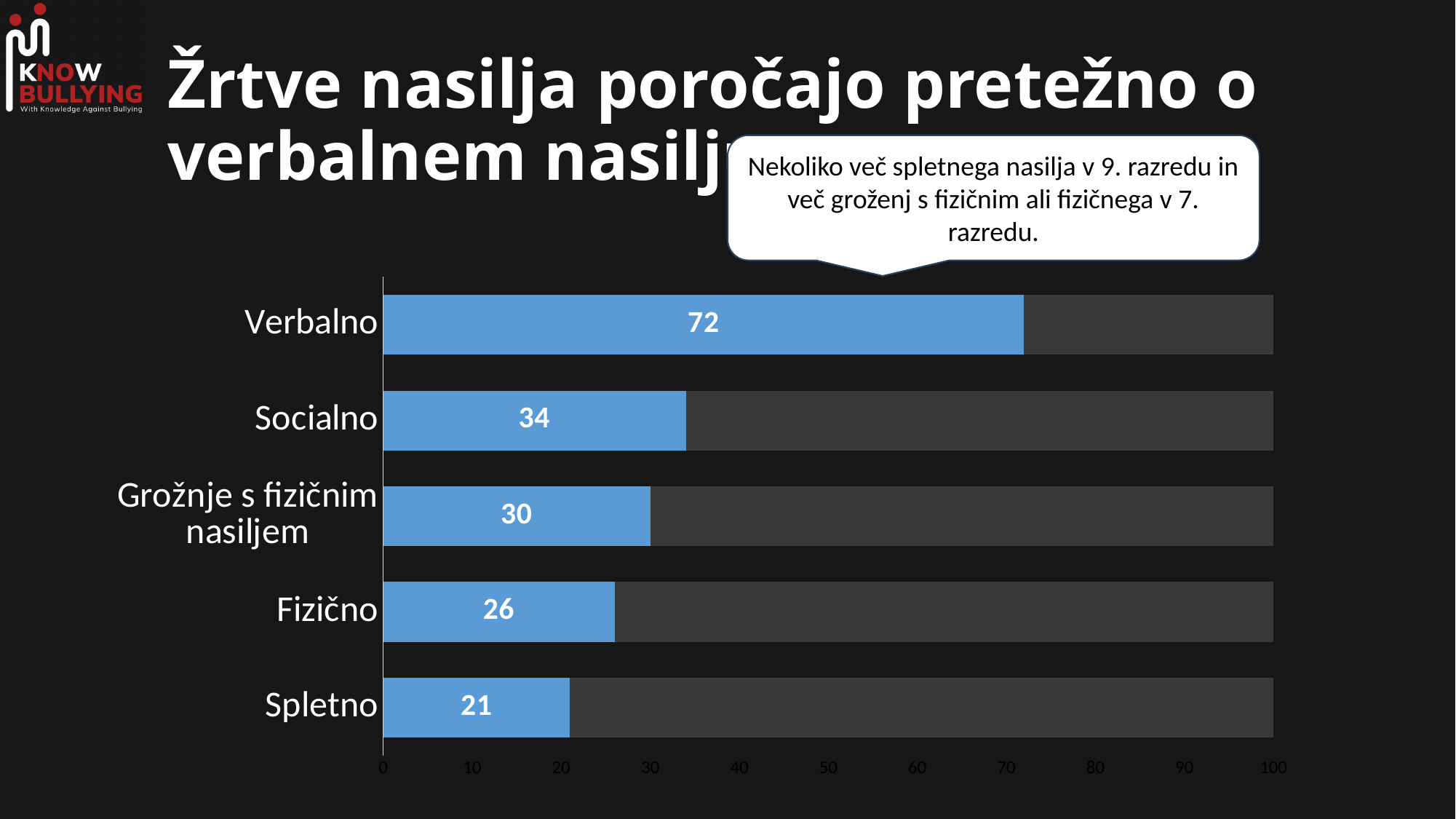
Is the value for Verbalno greater or less than 70? greater What kind of chart is shown on the slide? bar chart What is the value for Spletno? 21 What is the value for Verbalno? 72 Which category has the lowest value? Spletno How many categories are shown in the chart? 5 What is the value for Socialno? 34 What is the value for Grožnje s fizičnim nasiljem? 30 What is the difference between the values for Fizično and Spletno? 5 What is the difference between the values for Verbalno and Socialno? 38 Which is larger, the value for Socialno or the value for Fizično? Socialno Which category has the highest value? Verbalno